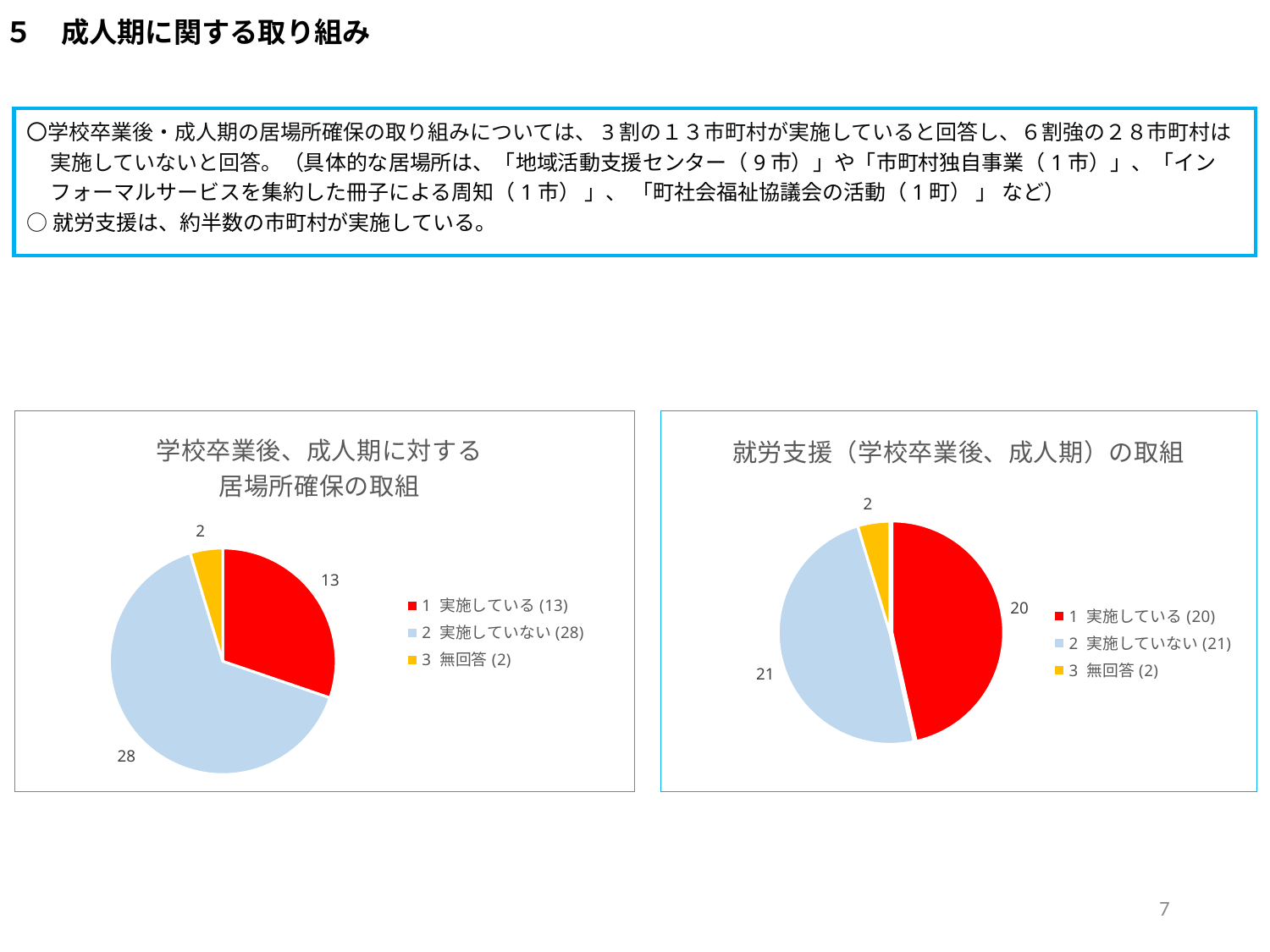
In the left pie chart (学校卒業後、成人期に対する居場所確保の取組), what is the value for 実施していない? 28 In the left pie chart (学校卒業後、成人期に対する居場所確保の取組), which category has the largest slice? 実施していない In the left pie chart (学校卒業後、成人期に対する居場所確保の取組), which is larger: 実施している or 無回答? 実施している In the right pie chart (就労支援（学校卒業後、成人期）の取組), which category has the smallest slice? 無回答 What kind of chart is the left chart (学校卒業後、成人期に対する居場所確保の取組)? Pie chart In the right pie chart (就労支援（学校卒業後、成人期）の取組), what is the value for 無回答? 2 In the left pie chart (学校卒業後、成人期に対する居場所確保の取組), what is the value for 実施している? 13 In the left pie chart (学校卒業後、成人期に対する居場所確保の取組), what is the difference between 実施していない and 実施している? 15 How many categories does the right pie chart (就労支援（学校卒業後、成人期）の取組) show? 3 In the right pie chart (就労支援（学校卒業後、成人期）の取組), what colour is the 実施している slice? Red In the right pie chart (就労支援（学校卒業後、成人期）の取組), what is the value for 実施している? 20 In the right pie chart (就労支援（学校卒業後、成人期）の取組), what is the difference between 実施していない and 実施している? 1